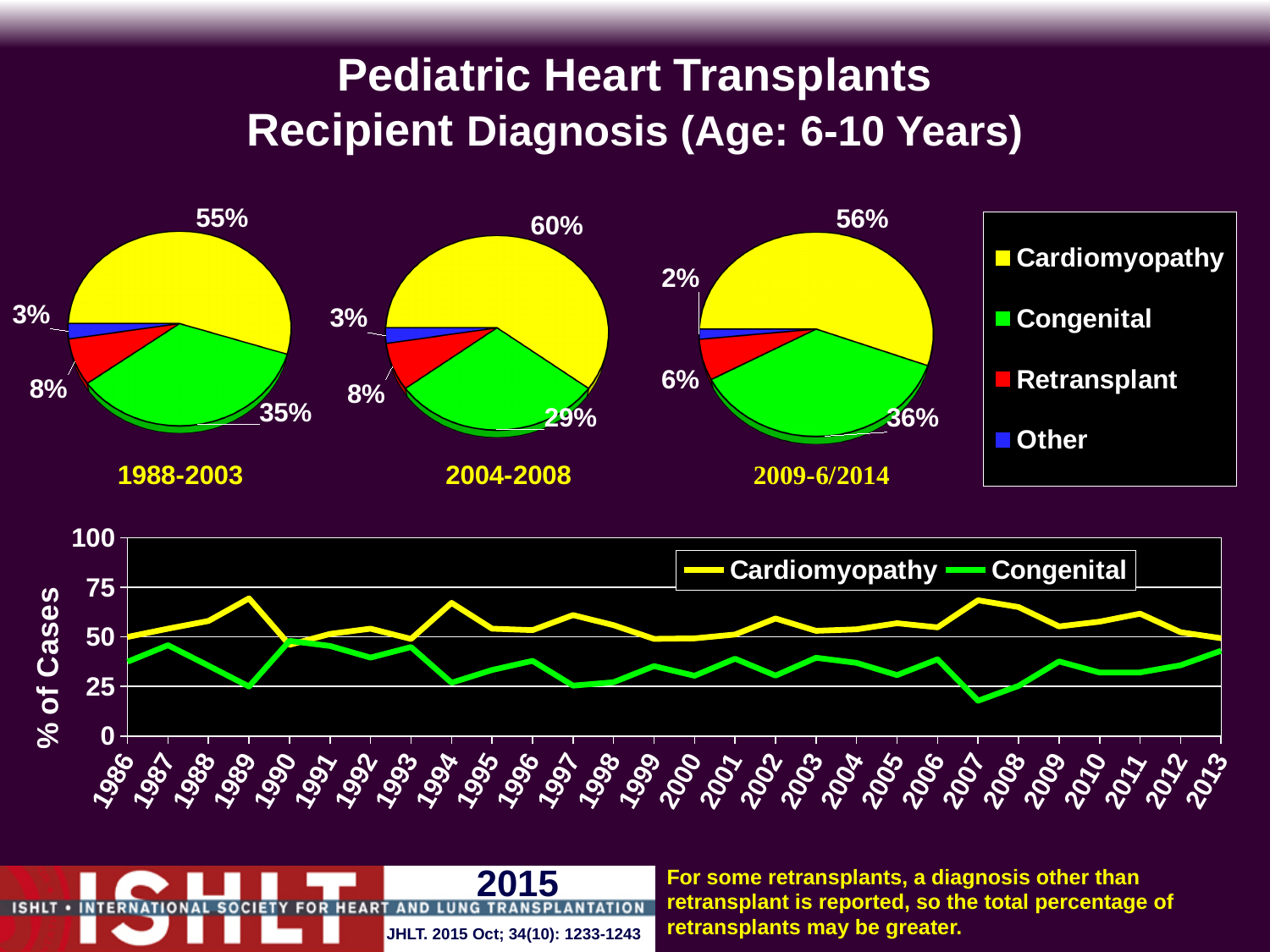
In the 2009-6/2014 pie chart, which diagnosis has the smallest share? Other How many diagnosis categories does the pie chart legend list? 4 Is the Cardiomyopathy share larger in the 2004-2008 pie chart or the 2009-6/2014 pie chart? 2004-2008 In the 1988-2003 pie chart, what is the difference between the Cardiomyopathy and Congenital percentages? 20% In the bottom line chart, is the Cardiomyopathy value for 1989 greater or less than 50? greater In the bottom line chart, how many series does the legend list? 2 What type of chart is the bottom chart showing % of Cases by year? Line chart In the 2004-2008 pie chart, which diagnosis has the largest share? Cardiomyopathy In the bottom line chart, is the Congenital value for 2007 greater or less than 25? less In the 2009-6/2014 pie chart, what percentage is Retransplant? 6% In the 2004-2008 pie chart, what percentage is Congenital? 29% In the 1988-2003 pie chart, what percentage is Cardiomyopathy? 55%